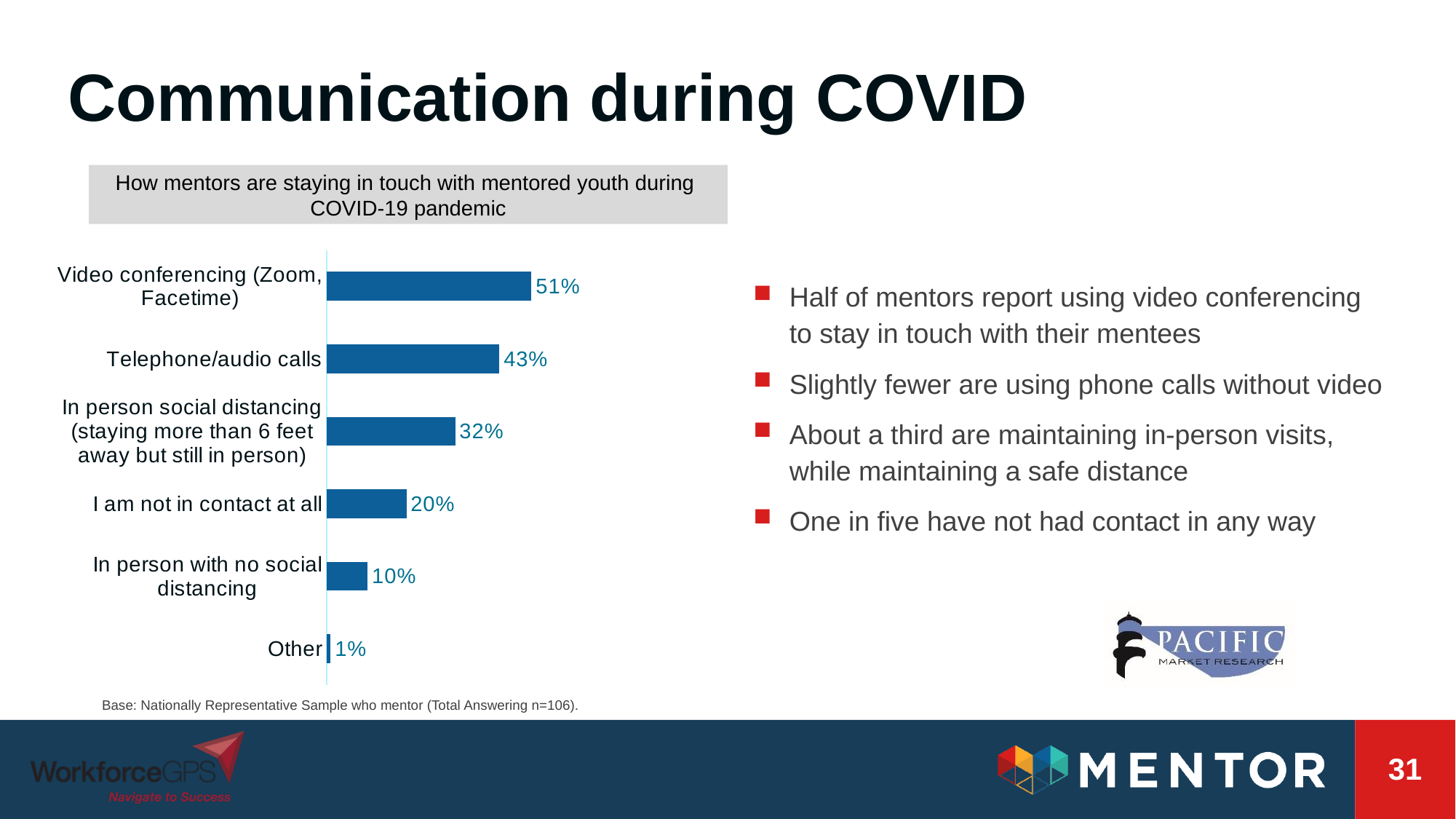
What is the difference in percentage points between in person social distancing and in person with no social distancing? 22 Which communication method has the highest percentage in the chart? Video conferencing (Zoom, Facetime) What percentage of mentors report using telephone/audio calls? 43% What type of chart is used on this slide? Bar chart What percentage of mentors report in person contact with no social distancing? 10% Which category has the lowest percentage in the chart? Other What percentage of mentors report using video conferencing (Zoom, Facetime) to stay in touch with mentored youth? 51% What percentage of mentors say they are not in contact at all? 20% What is the title shown above the chart? How mentors are staying in touch with mentored youth during COVID-19 pandemic Which is larger: the percentage for in person social distancing or the percentage for 'I am not in contact at all'? In person social distancing How many categories are shown in the chart? 6 What is the difference in percentage points between video conferencing and telephone/audio calls? 8